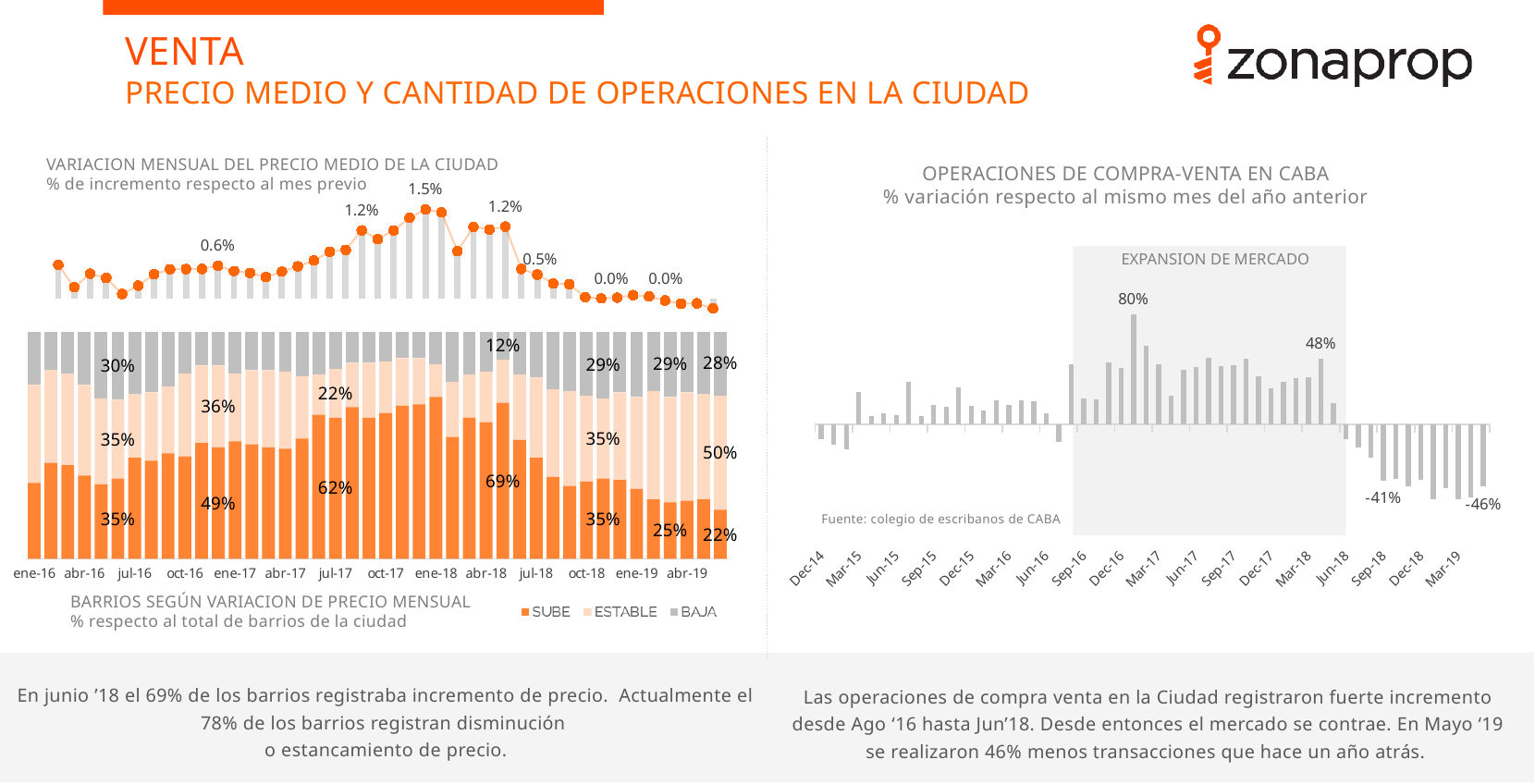
In the 'OPERACIONES DE COMPRA-VENTA EN CABA' chart, what is the highest labeled value? 80% In the 'OPERACIONES DE COMPRA-VENTA EN CABA' chart, what is the difference between the 80% label and the 48% label? 32 percentage points In the 'OPERACIONES DE COMPRA-VENTA EN CABA' chart, which is larger: the value labeled near Dec-16 or the value labeled near Mar-18? The value near Dec-16 (80%) In the 'OPERACIONES DE COMPRA-VENTA EN CABA' chart, are the values from Sep-18 to Mar-19 greater or less than 0? less In the 'VARIACION MENSUAL DEL PRECIO MEDIO DE LA CIUDAD' chart, do the values rise or fall after the 1.5% peak? Fall What are the legend entries of the 'BARRIOS SEGÚN VARIACION DE PRECIO MENSUAL' chart? SUBE, ESTABLE, BAJA In the 'VARIACION MENSUAL DEL PRECIO MEDIO DE LA CIUDAD' chart, what is the highest labeled value? 1.5% What kind of chart is the 'OPERACIONES DE COMPRA-VENTA EN CABA' chart on the right? Bar chart In the 'BARRIOS SEGÚN VARIACION DE PRECIO MENSUAL' chart, what is the total of the last stacked bar labeled 28%, 50% and 22%? 100% In the 'BARRIOS SEGÚN VARIACION DE PRECIO MENSUAL' chart, what is the highest labeled SUBE value? 69% How many series does the legend of the 'BARRIOS SEGÚN VARIACION DE PRECIO MENSUAL' chart list? 3 In the 'OPERACIONES DE COMPRA-VENTA EN CABA' chart, what is the lowest labeled value? -46%